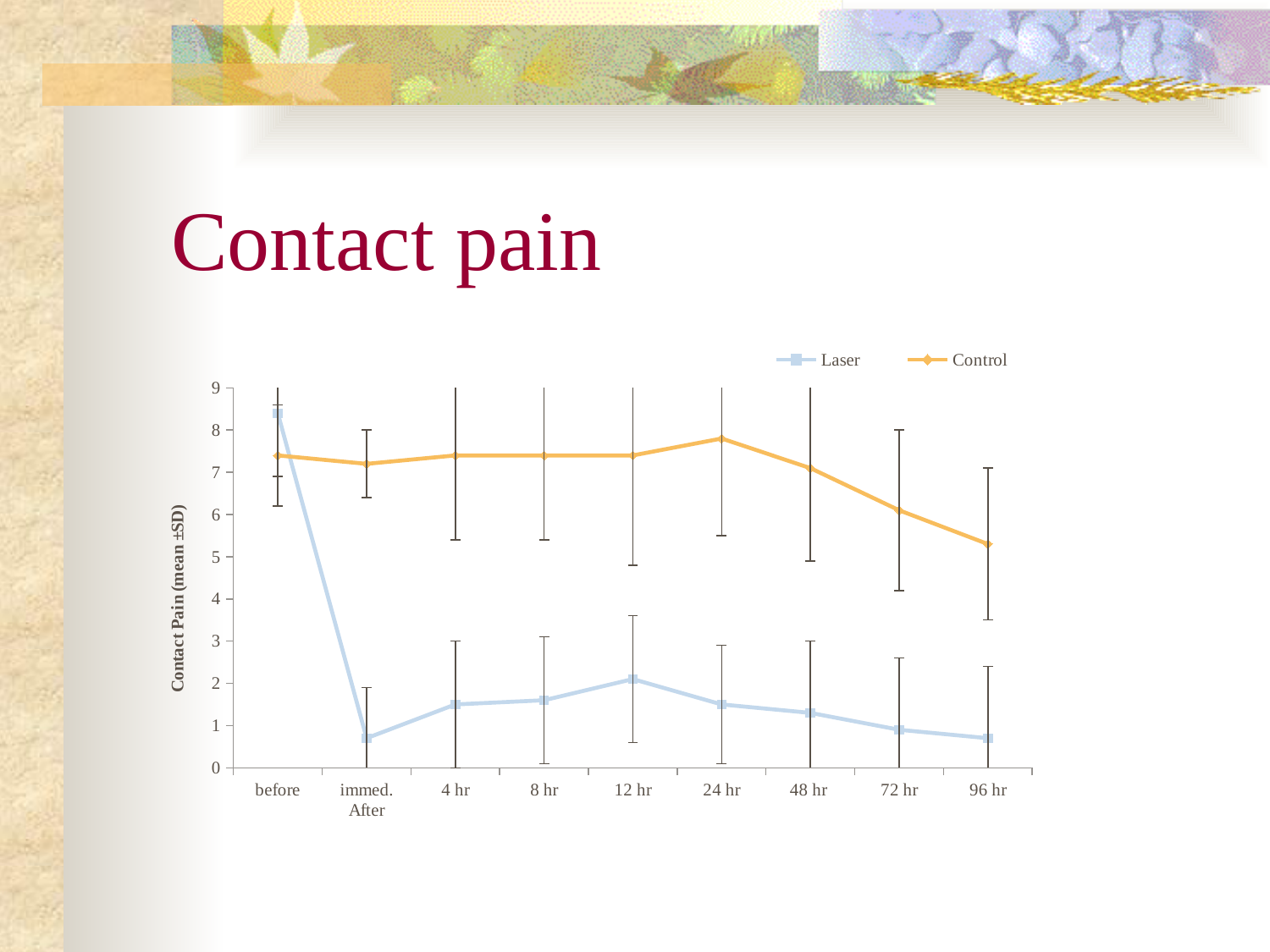
At which time point is the Control series lowest? 96 hr What is the label of the y axis? Contact Pain (mean ±SD) Is the Laser value at 'immed. After' greater or less than 1? less At which time point is the Laser series highest? before At which time point is the Control series highest? 24 hr Does the Control series rise or fall from 24 hr to 96 hr? fall At 4 hr, which series has the larger value, Laser or Control? Control How many series does the legend list? 2 Is the Control value at 96 hr greater or less than 6? less How many time points are plotted along the x axis? 9 Is the Laser value at 'before' greater or less than 8? greater What kind of chart is shown on the slide? line chart